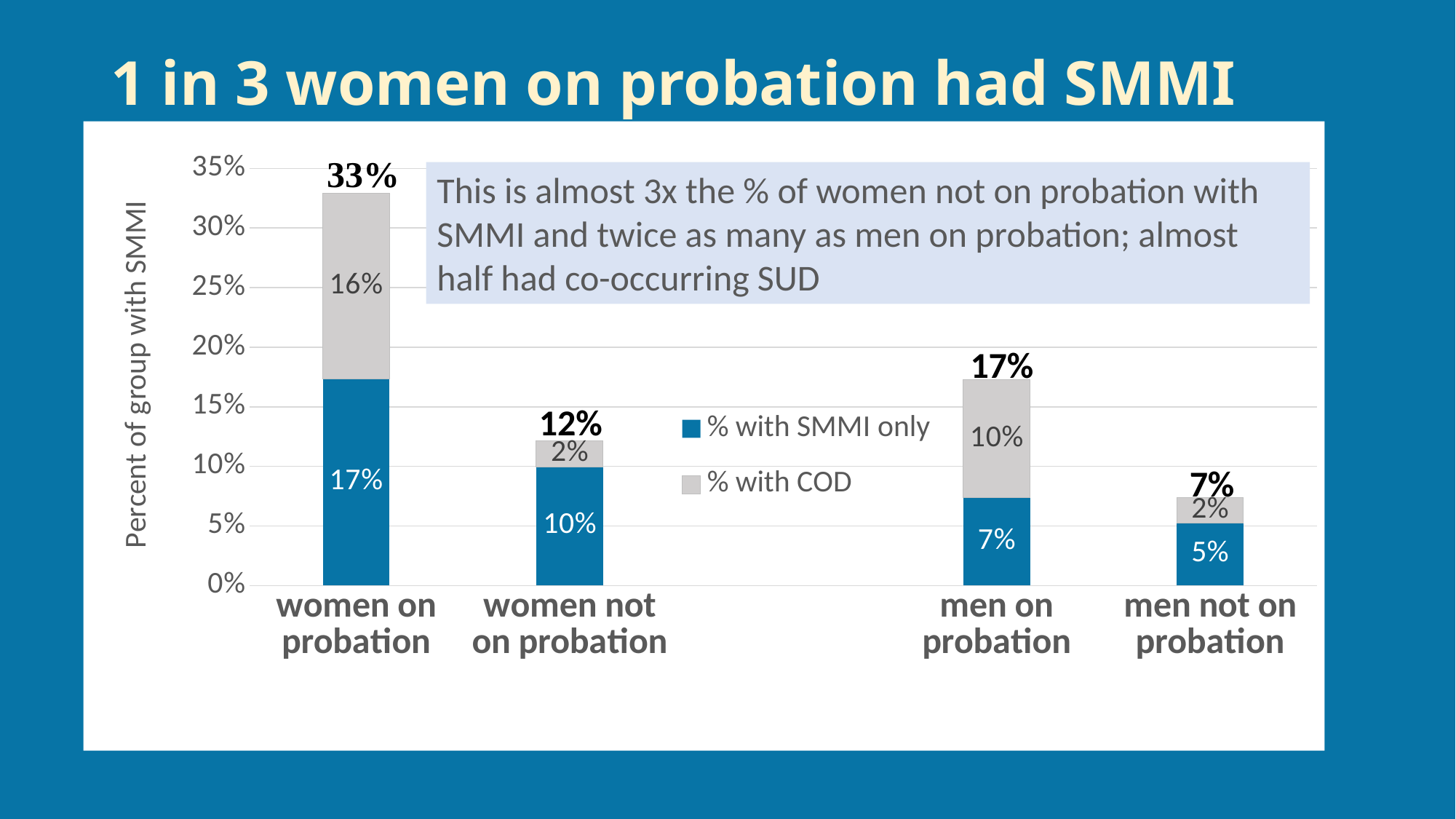
Which colour represents '% with COD' in the legend? grey What is the '% with COD' value for men on probation? 10% How many series does the legend list? 2 What is the label of the y axis? Percent of group with SMMI What is the total labelled above the bar for women not on probation? 12% What is the difference between the total for women on probation and the total for men on probation? 16% Which category has the lowest total bar? men not on probation How many categories are shown on the x axis? 4 What kind of chart is shown on the slide? stacked bar chart Which is larger: the '% with COD' for women on probation or the '% with COD' for men on probation? women on probation What is the '% with SMMI only' value for women on probation? 17% Which category has the highest total bar? women on probation